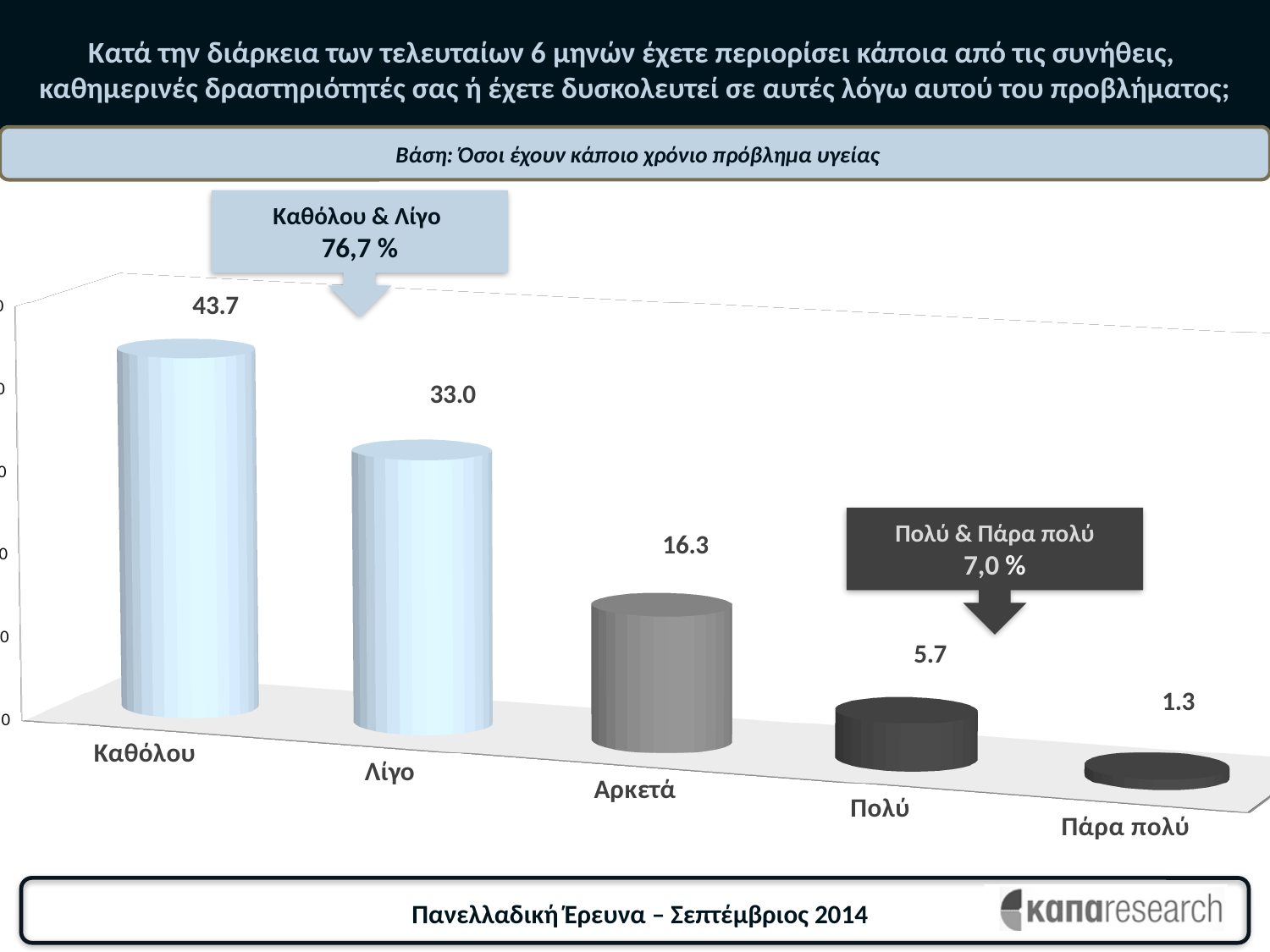
How many categories are shown on the chart? 5 What is the difference between the values for Καθόλου and Λίγο? 10.7 What is the value for Αρκετά? 16.3 What kind of chart is shown on the slide? Bar chart What is the value for Πάρα πολύ? 1.3 What is the value for Πολύ? 5.7 Which category has the highest value? Καθόλου What is the value for Καθόλου? 43.7 What combined percentage does the callout give for Καθόλου & Λίγο? 76,7 % What is the value for Λίγο? 33.0 Which category has the lowest value? Πάρα πολύ Which is larger, the value for Αρκετά or the value for Πολύ? Αρκετά